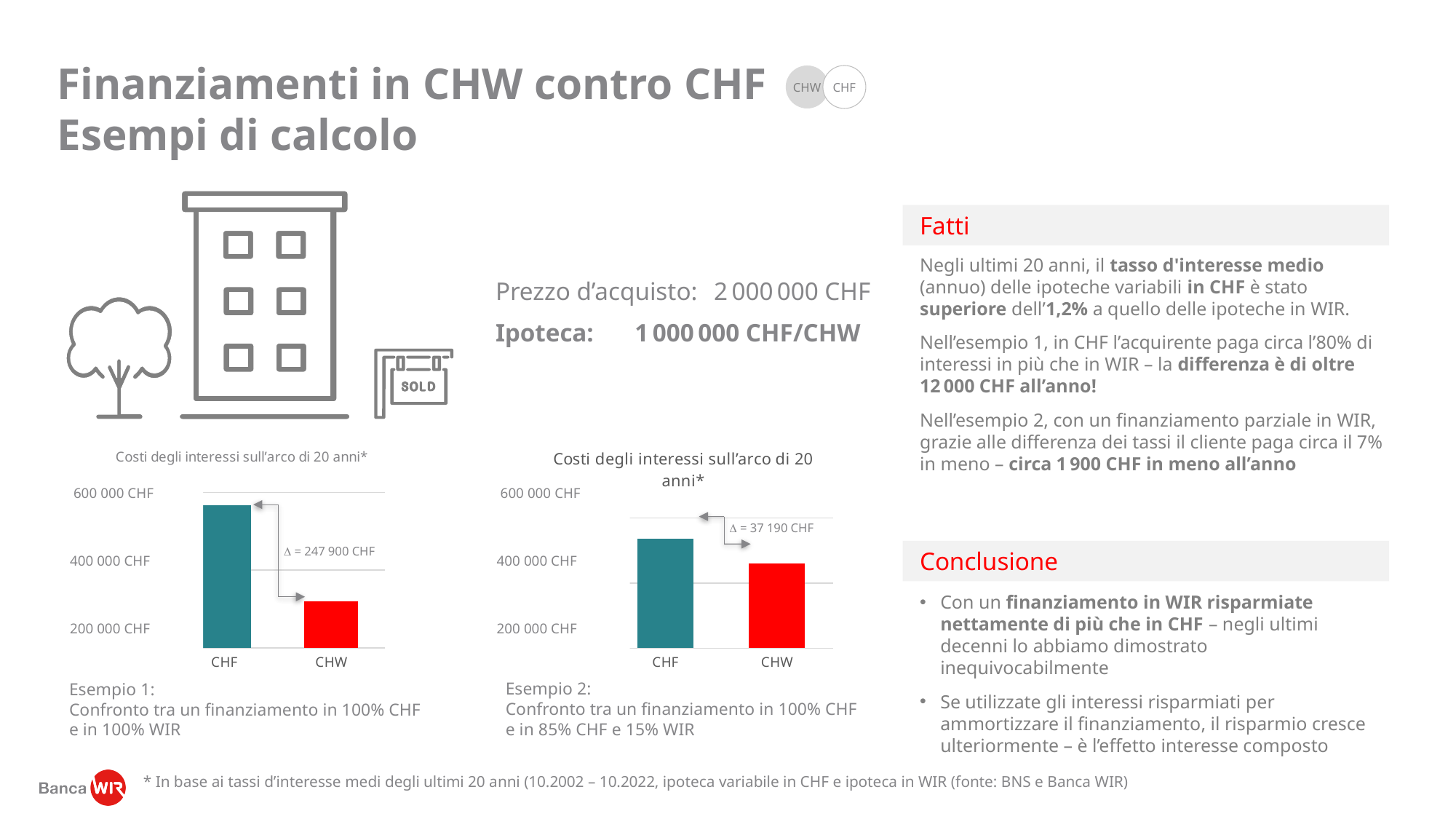
On the right chart (Esempio 2), is the value for CHF greater or less than 400 000 CHF? greater On the right chart (Esempio 2), which is larger, the CHF bar or the CHW bar? CHF On the left chart (Esempio 1), is the value for CHW greater or less than 400 000 CHF? less On the left chart (Esempio 1), which category has the higher interest cost? CHF On the left chart (Esempio 1), is the value for CHF greater or less than 400 000 CHF? greater On the left chart (Esempio 1), what difference between the CHF and CHW bars is annotated? Δ = 247 900 CHF What is the title of the left chart (Esempio 1)? Costi degli interessi sull'arco di 20 anni* On the right chart (Esempio 2), which category has the lower interest cost? CHW On the right chart (Esempio 2), what difference between the CHF and CHW bars is annotated? Δ = 37 190 CHF On the left chart (Esempio 1), how many categories are plotted? 2 On the left chart (Esempio 1), what kind of chart is shown? bar chart